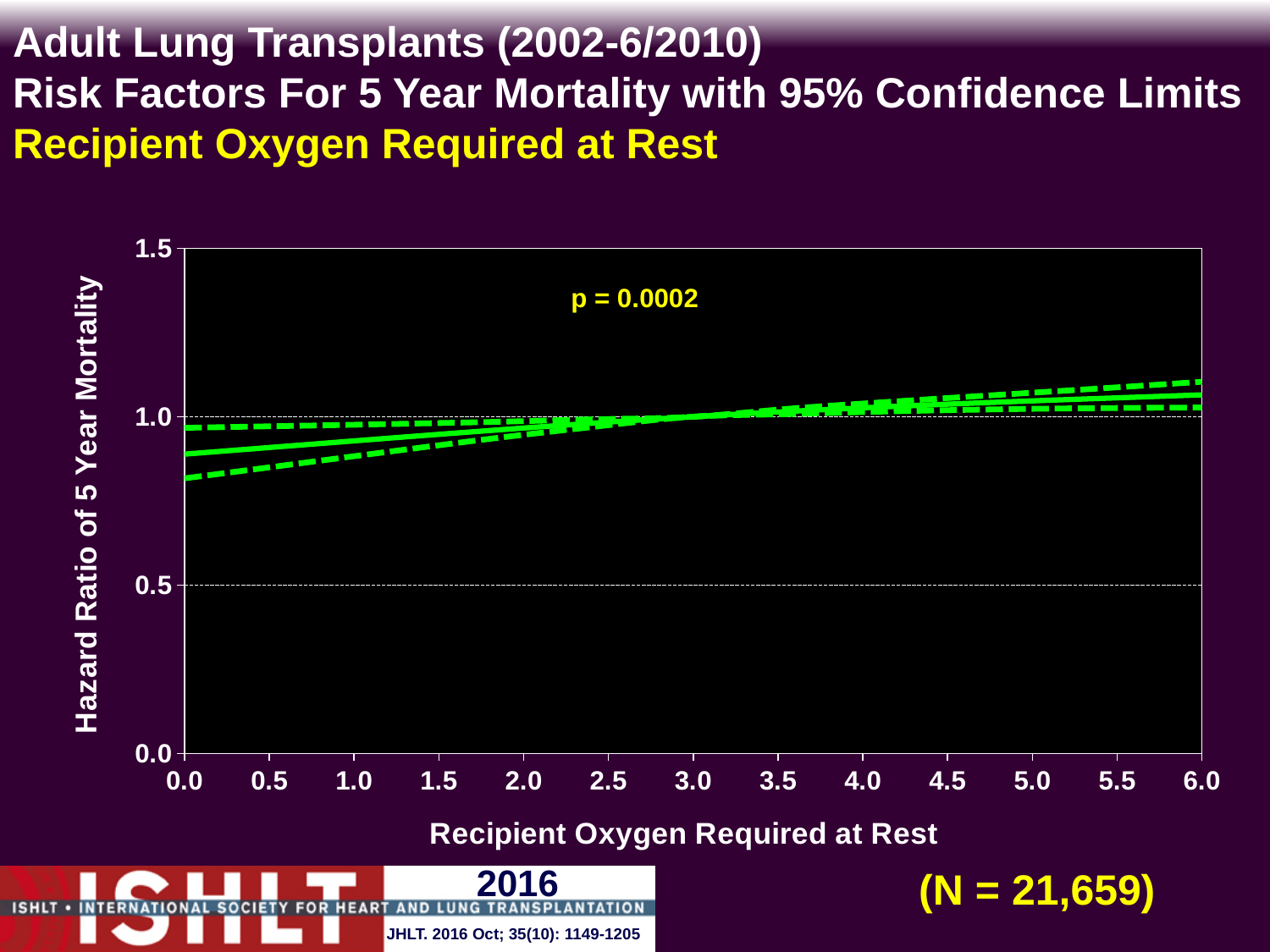
Does the hazard ratio rise or fall as Recipient Oxygen Required at Rest increases from 0.0 to 6.0? rise Is the hazard ratio of the solid line at a Recipient Oxygen Required at Rest of 0.0 greater or less than 1.0? less Is the hazard ratio of the solid line at a Recipient Oxygen Required at Rest of 6.0 greater or less than 0.5? greater How many lines are plotted on the chart (including the confidence limit lines)? 3 What is the sample size (N) shown on the slide? N = 21,659 Is the hazard ratio of the solid line higher at a Recipient Oxygen Required at Rest of 6.0 or at 0.0? 6.0 What is the maximum value shown on the x axis? 6.0 Is the hazard ratio of the solid line at a Recipient Oxygen Required at Rest of 0.0 greater or less than 0.5? greater What kind of chart is shown on the slide? line chart What is the label of the y axis? Hazard Ratio of 5 Year Mortality